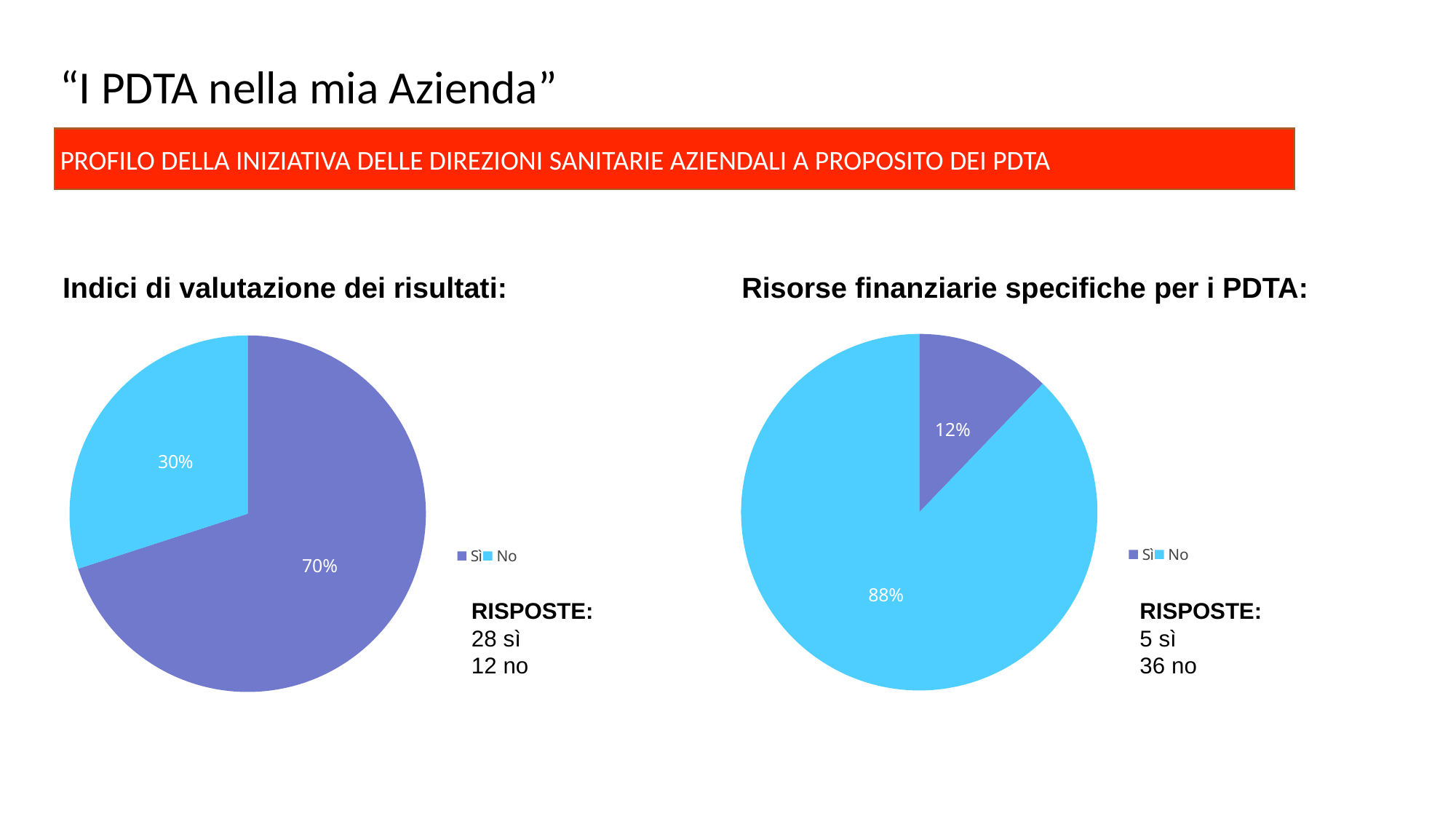
In the 'Risorse finanziarie specifiche per i PDTA' chart, what share of the pie is 'No'? 88% In the 'Indici di valutazione dei risultati' chart, what share of the pie is 'Sì'? 70% In the 'Indici di valutazione dei risultati' chart, which slice is the largest? Sì In the 'Risorse finanziarie specifiche per i PDTA' chart, what share of the pie is 'Sì'? 12% What kind of chart is the 'Risorse finanziarie specifiche per i PDTA' chart? pie chart How many slices does the 'Indici di valutazione dei risultati' pie chart have? 2 In the 'Indici di valutazione dei risultati' chart, is the 'Sì' slice larger or smaller than the 'No' slice? larger How many entries does the legend of the 'Risorse finanziarie specifiche per i PDTA' chart list? 2 In the 'Indici di valutazione dei risultati' chart, what colour is the 'No' slice? light blue In the 'Risorse finanziarie specifiche per i PDTA' chart, what is the difference in percentage points between the 'No' and 'Sì' slices? 76 In the 'Risorse finanziarie specifiche per i PDTA' chart, which slice is the smallest? Sì